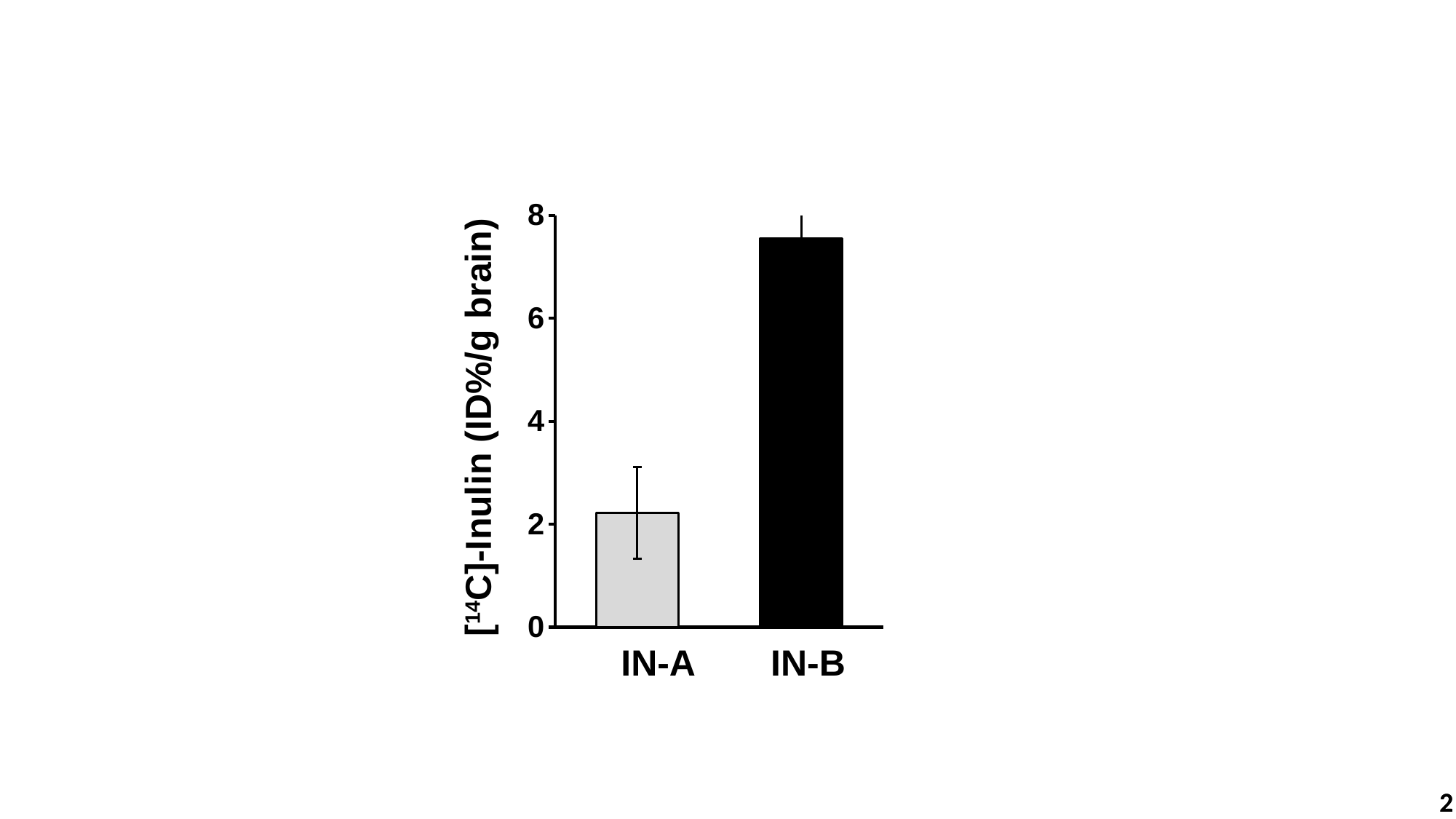
Which category has the lowest value? IN-A Is the value for IN-B greater or less than 6? greater Which is larger, the value for IN-A or the value for IN-B? IN-B What is the highest tick value shown on the y axis? 8 How many categories are plotted on the x axis? 2 What is the label of the y axis? [14C]-Inulin (ID%/g brain) Is the value for IN-A greater or less than 4? less Is the value for IN-B greater or less than 8? less What kind of chart is shown on the slide? bar chart Which category has the highest value? IN-B